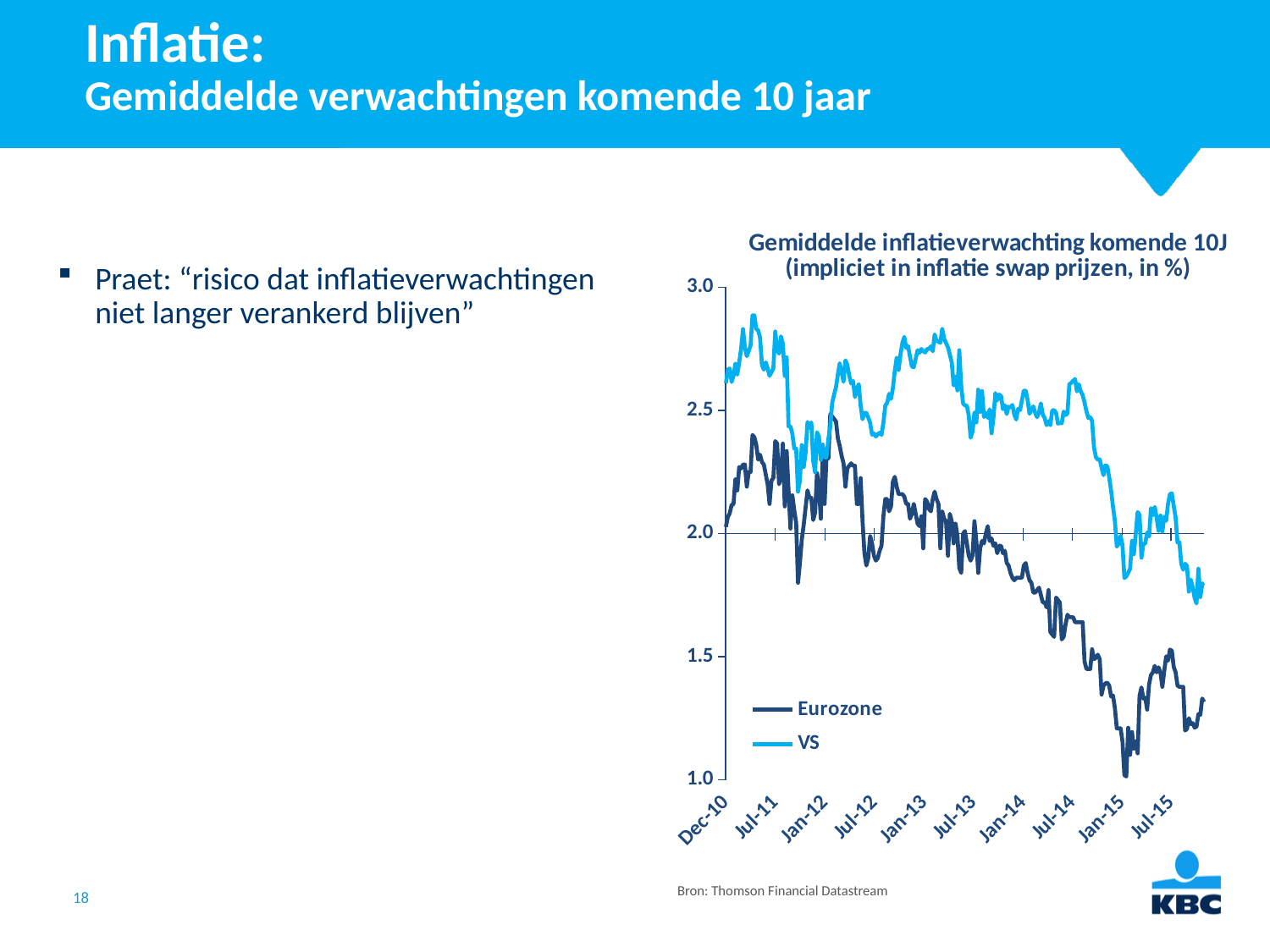
Is the value for Eurozone at Jul-11 greater or less than 2.0? greater Does the Eurozone line rise or fall overall from Dec-10 to Jul-15? fall Is the value for Eurozone at Jul-14 greater or less than 2.0? less Is the value for VS at Jan-15 greater or less than 2.5? less What is the title of the chart? Gemiddelde inflatieverwachting komende 10J (impliciet in inflatie swap prijzen, in %) What kind of chart is shown on the slide? line chart What are the two series named in the chart legend? Eurozone and VS How many date labels are shown on the x axis of the chart? 10 Which series is higher at Jul-15, Eurozone or VS? VS How many series does the legend of the chart list? 2